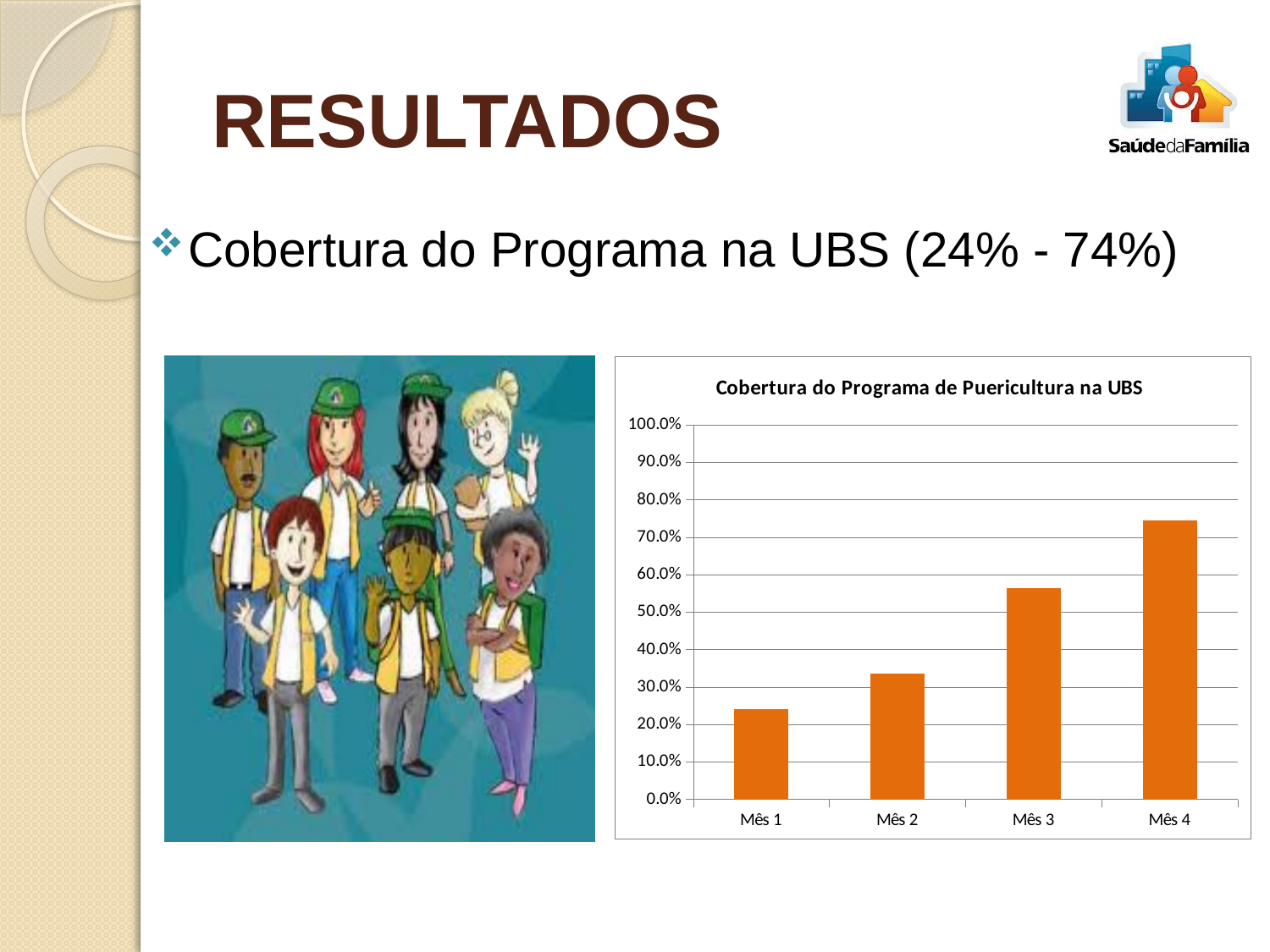
How many categories (months) are plotted in the chart? 4 What kind of chart is shown on the slide? bar chart What is the title of the chart? Cobertura do Programa de Puericultura na UBS Is the value for Mês 2 greater or less than 30.0%? greater Which month has the highest coverage in the chart? Mês 4 Is the value for Mês 1 greater or less than 30.0%? less Do the values rise or fall from Mês 1 to Mês 4? rise Which month has the lowest coverage in the chart? Mês 1 Is the value for Mês 4 greater or less than 80.0%? less Which is larger, the value for Mês 2 or the value for Mês 3? Mês 3 What colour are the bars in the chart? orange